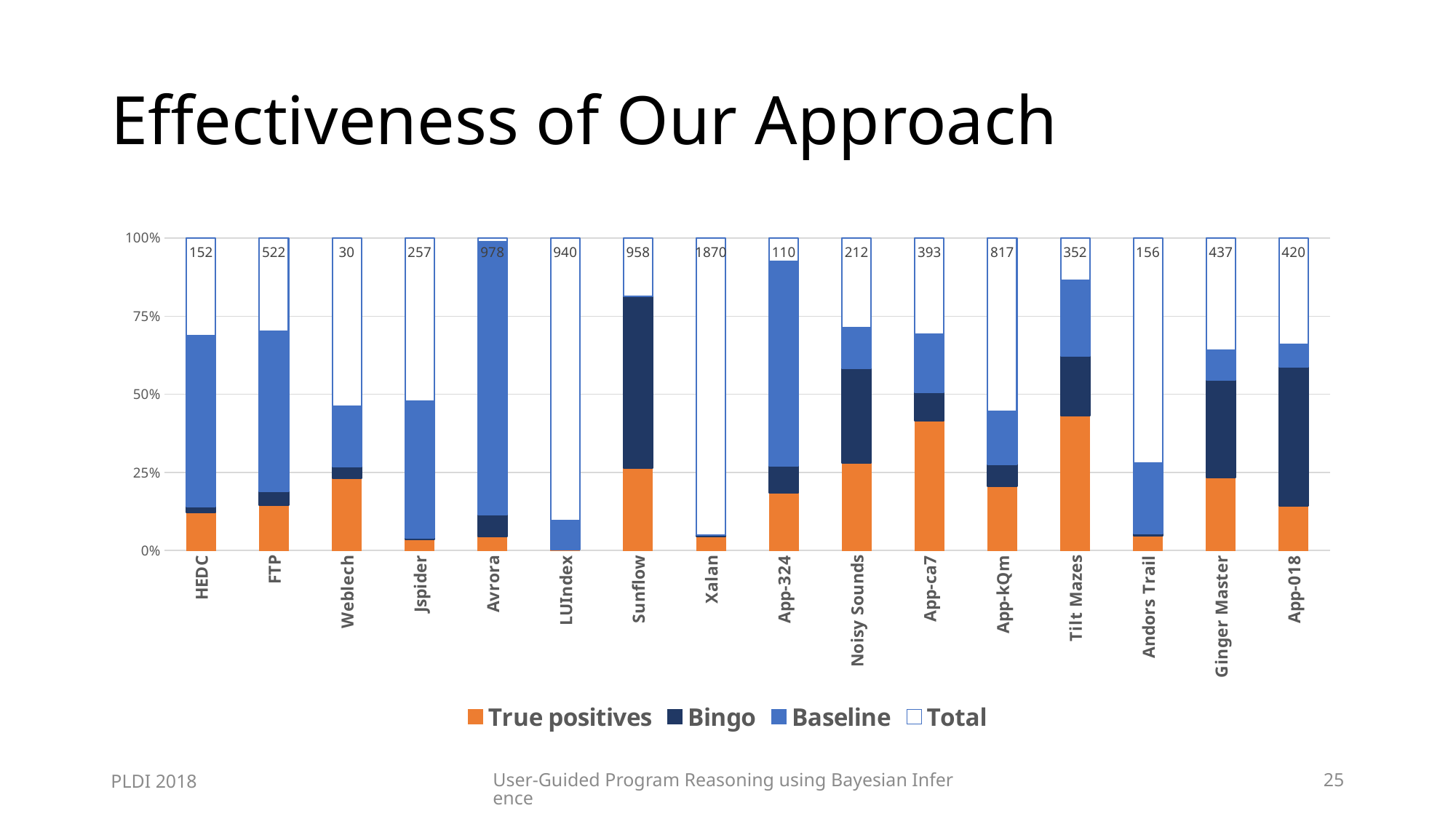
What number is printed above the Weblech bar? 30 Which category has the smallest number printed above its bar? Weblech Which has the larger number printed above its bar, Avrora or Sunflow? Avrora How many categories are shown on the x axis? 16 How many series does the legend list? 4 What is the difference between the numbers printed above the Xalan and LUIndex bars? 930 What number is printed above the Avrora bar? 978 What kind of chart is shown on the slide? Stacked bar chart What number is printed above the Xalan bar? 1870 Which category has the largest number printed above its bar? Xalan Is the top of the Baseline segment for LUIndex greater or less than 25%? less Is the True positives segment for Tilt Mazes greater or less than 25%? greater